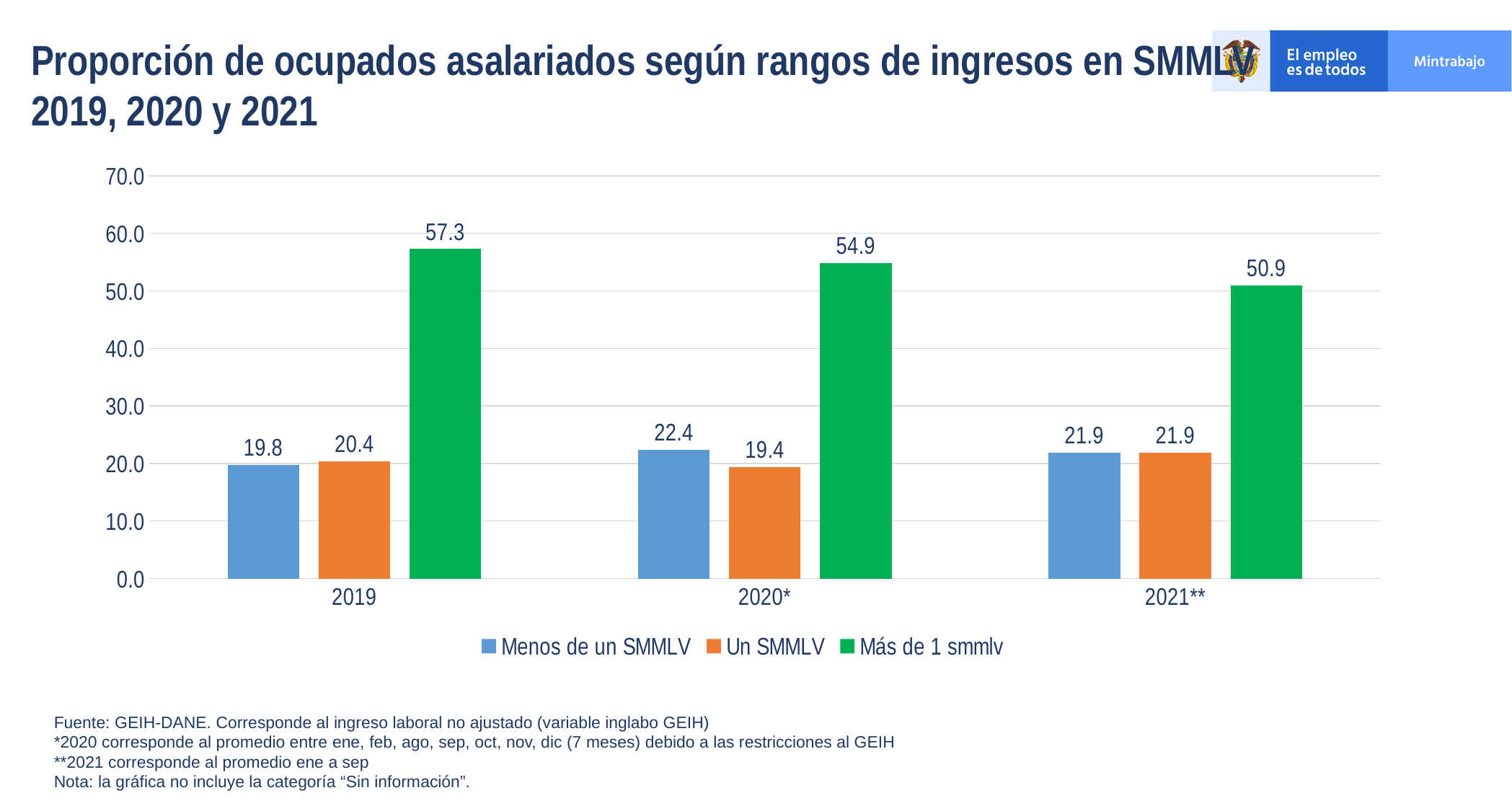
What is the value for "Menos de un SMMLV" in 2020*? 22.4 What is the value for "Un SMMLV" in 2021**? 21.9 In which year is the "Más de 1 smmlv" value highest? 2019 How many series does the legend list? 3 What kind of chart is shown on the slide? Bar chart What is the difference between the "Más de 1 smmlv" values for 2019 and 2021**? 6.4 Does the "Más de 1 smmlv" series rise or fall from 2019 to 2021**? Fall In which year is the "Un SMMLV" value lowest? 2020* Which is larger in 2020*: "Menos de un SMMLV" or "Un SMMLV"? Menos de un SMMLV How many year categories are shown on the x axis? 3 Is the value for "Más de 1 smmlv" in 2020* greater or less than 50.0? greater What is the value for "Más de 1 smmlv" in 2019? 57.3